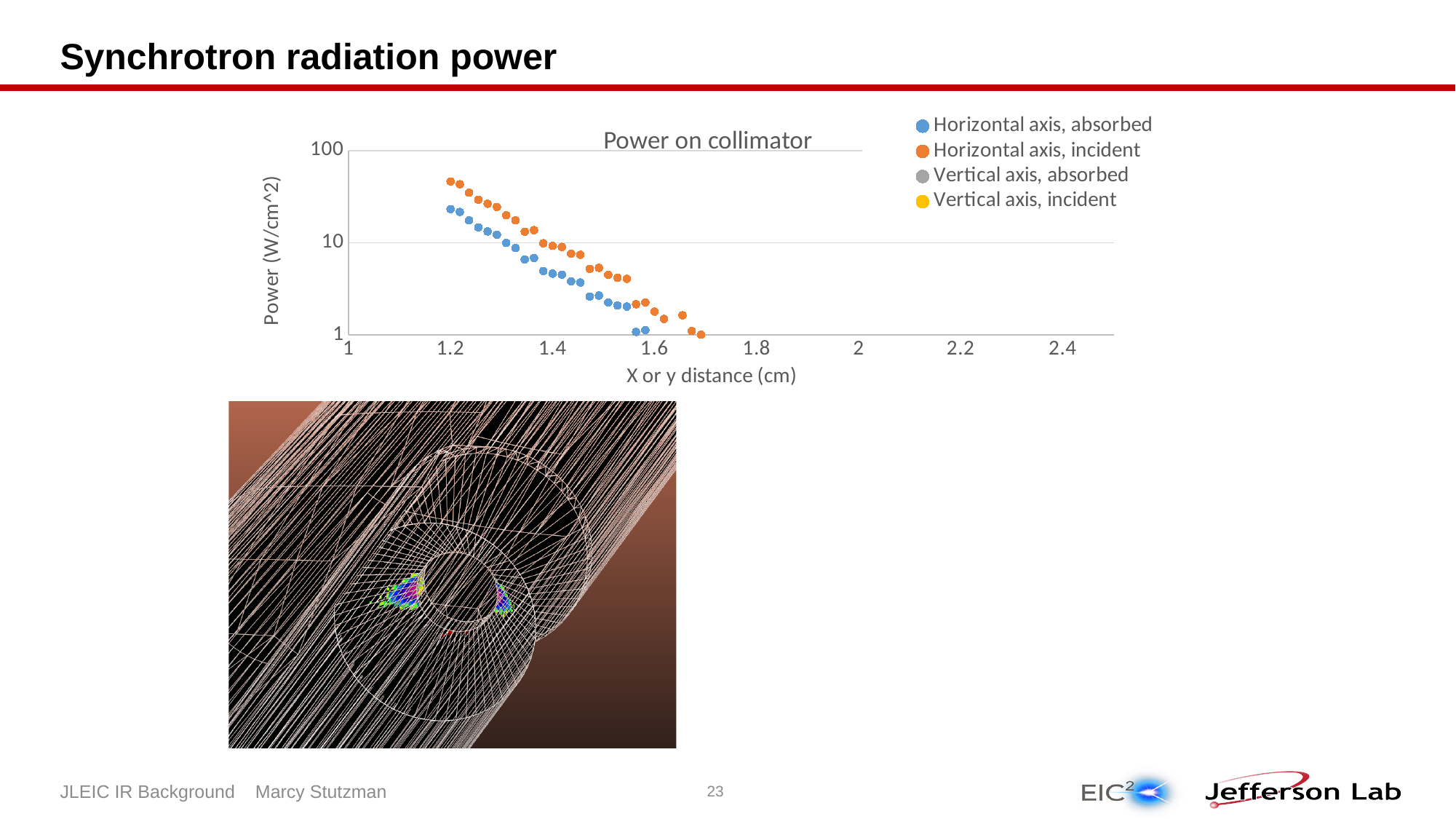
Is the value for 'Horizontal axis, absorbed' at a distance of 1.2 cm greater or less than 10? greater Which of the two plotted series has the higher power values across the distance range? Horizontal axis, incident Is the value for 'Horizontal axis, incident' at a distance of 1.6 cm greater or less than 10? less Is the value for 'Horizontal axis, incident' at a distance of 1.2 cm greater or less than 100? less What kind of chart is shown on the slide? scatter chart What is the title of the chart? Power on collimator What is the label of the y axis of the chart? Power (W/cm^2) Do the plotted power values rise or fall as the x or y distance increases? fall How many series does the chart legend list? 4 At a distance of 1.2 cm, which series has the larger value: 'Horizontal axis, absorbed' or 'Horizontal axis, incident'? Horizontal axis, incident